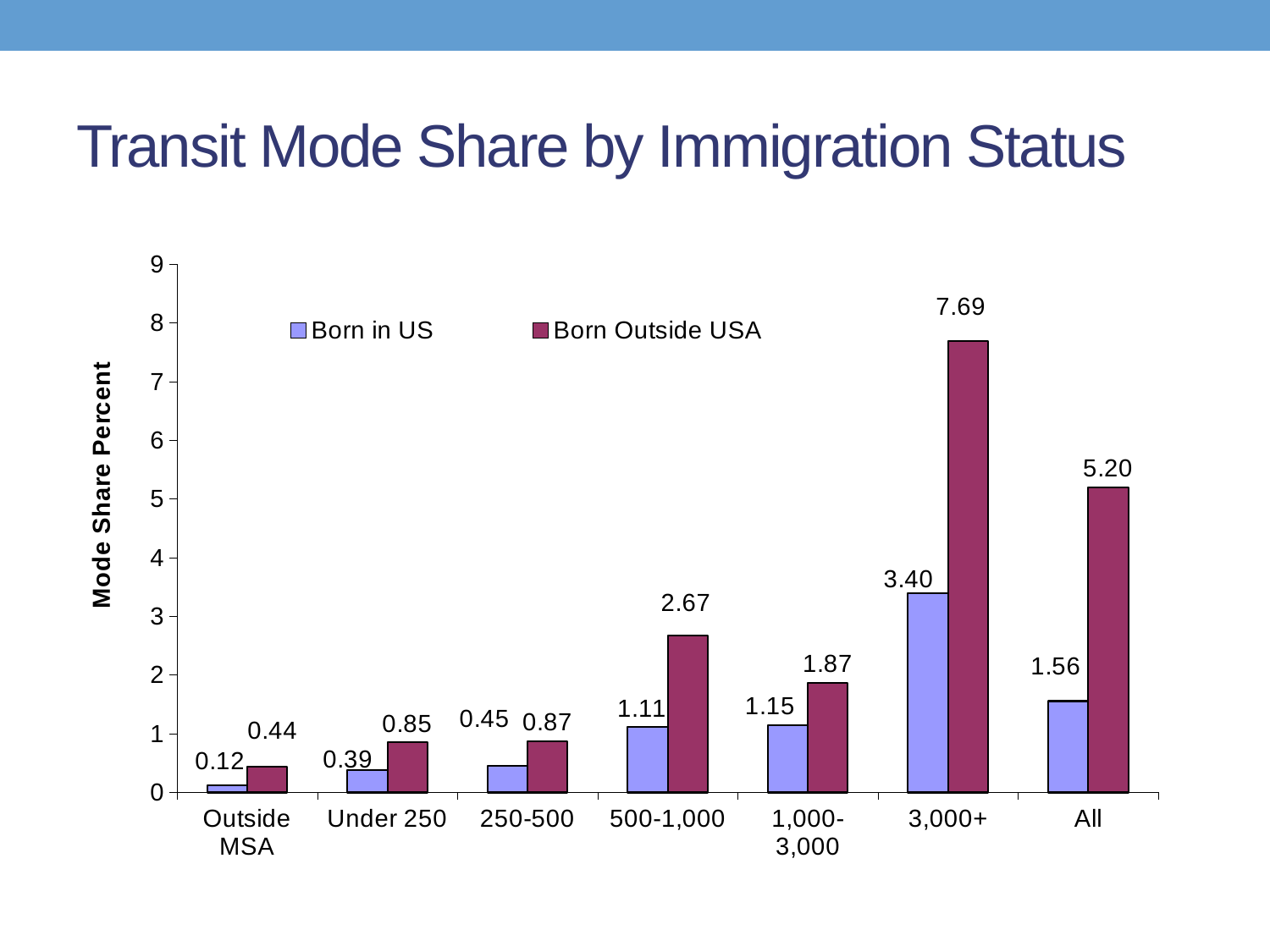
Which category has the lowest value for Born in US? Outside MSA What is the difference between Born Outside USA and Born in US in the All category? 3.64 What kind of chart is shown on the slide? Bar chart What is the transit mode share for Born in US in the Outside MSA category? 0.12 Which is larger in the 500-1,000 category: Born in US or Born Outside USA? Born Outside USA What is the label of the vertical axis? Mode Share Percent What is the transit mode share for Born in US in the All category? 1.56 How many categories are shown on the x axis? 7 Which category has the highest value for Born Outside USA? 3,000+ What is the transit mode share for Born Outside USA in the 3,000+ category? 7.69 What is the difference between Born Outside USA and Born in US in the 3,000+ category? 4.29 How many series does the legend list? 2